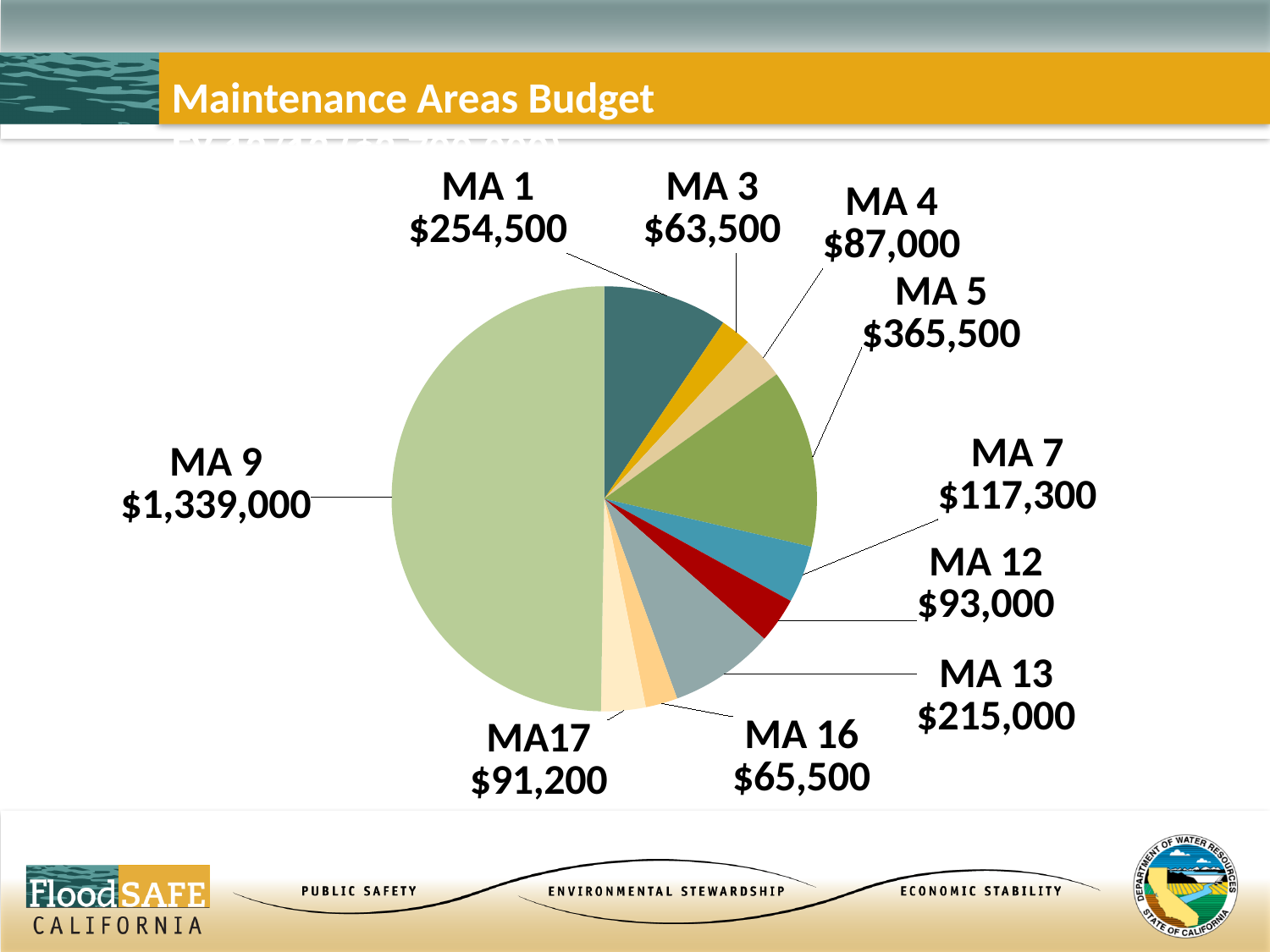
Which has a larger budget, MA 4 or MA 16? MA 4 What is the budget value shown for MA 9? $1,339,000 How many maintenance areas (slices) are shown in the pie chart? 10 What is the budget value shown for MA 5? $365,500 What is the difference between the budgets of MA 5 and MA 1? $111,000 What is the budget value shown for MA 13? $215,000 What type of chart is shown on the slide? Pie chart Which maintenance area has the largest budget in the pie chart? MA 9 What is the difference between the budgets of MA 13 and MA 12? $122,000 What is the title of the slide containing the chart? Maintenance Areas Budget What is the budget value shown for MA 7? $117,300 Which maintenance area has the smallest budget in the pie chart? MA 3